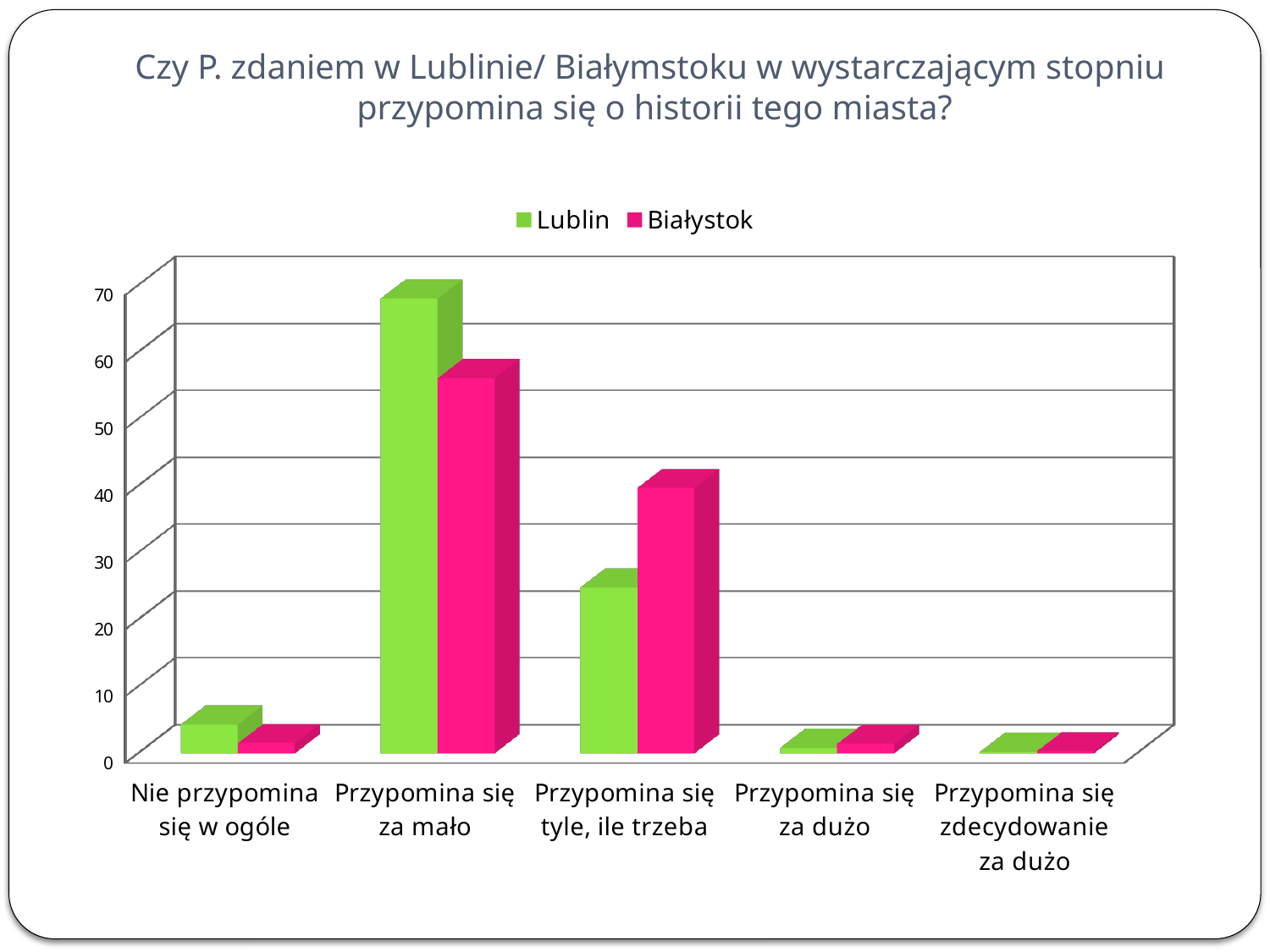
For the category 'Przypomina się za mało', which series has the larger value, Lublin or Białystok? Lublin What is the highest value shown on the vertical axis? 70 Which category has the highest value for Lublin? Przypomina się za mało Which category has the highest value for Białystok? Przypomina się za mało Is the Lublin value for 'Przypomina się za mało' greater or less than 60? greater For the category 'Przypomina się tyle, ile trzeba', which series has the larger value, Lublin or Białystok? Białystok How many series does the legend list? 2 How many categories are shown on the x axis? 5 What kind of chart is shown on the slide? bar chart Which colour represents the Białystok series in the legend? pink Is the Białystok value for 'Przypomina się tyle, ile trzeba' greater or less than 30? greater Is the Lublin value for 'Przypomina się tyle, ile trzeba' greater or less than 30? less